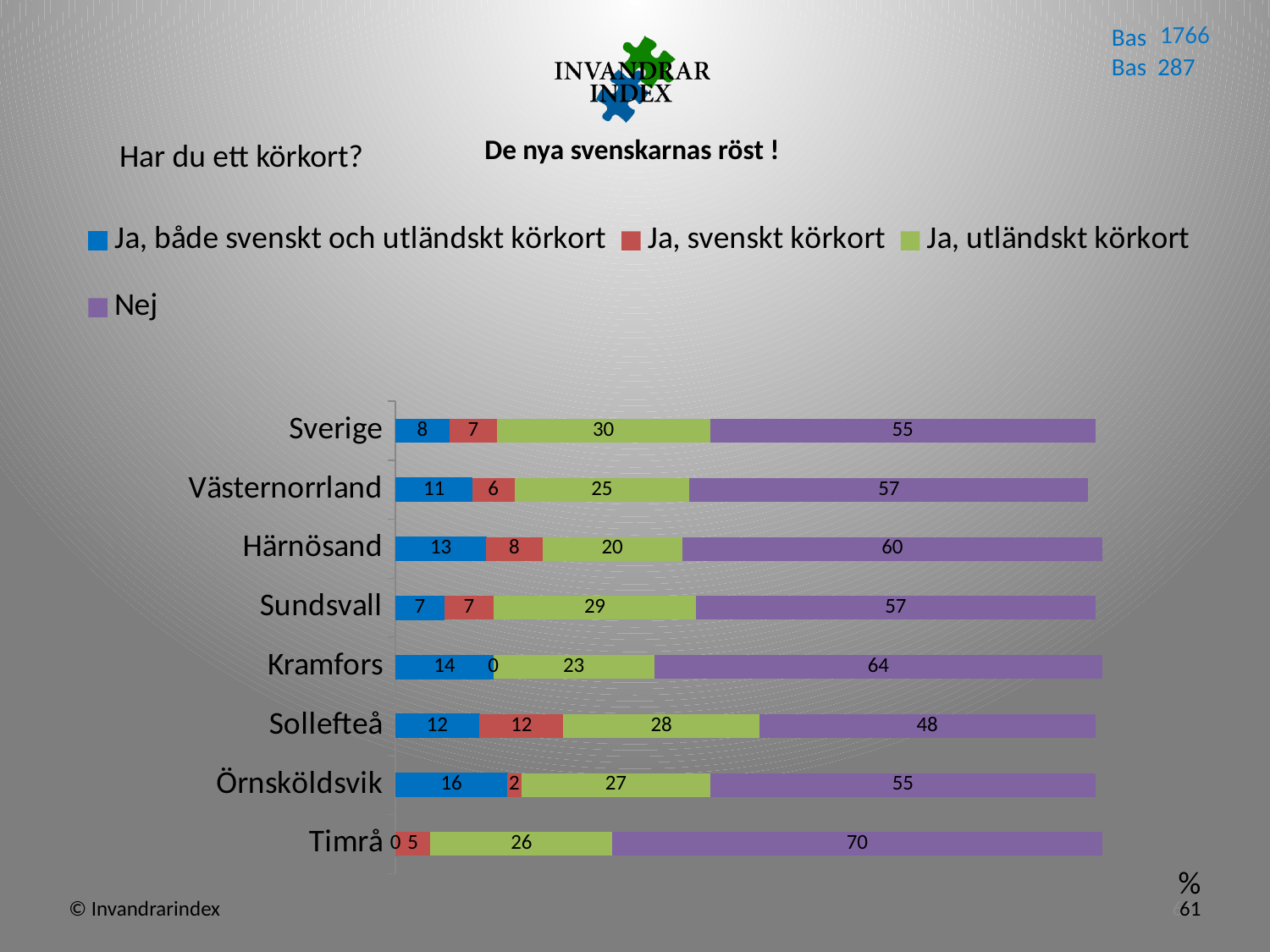
What is the value for "Nej" for Timrå? 70 What is the difference between the "Nej" values for Timrå and Sollefteå? 22 What is the total of the stacked bar for Sollefteå? 100 What is the value for "Ja, både svenskt och utländskt körkort" for Örnsköldsvik? 16 What is the value for "Ja, utländskt körkort" for Sverige? 30 What is the value for "Ja, svenskt körkort" for Kramfors? 0 What kind of chart is shown on the slide? Stacked bar chart Which category has the lowest value for "Nej"? Sollefteå How many series does the legend list? 4 Which category has the highest value for "Nej"? Timrå Which is larger, the "Ja, utländskt körkort" value for Sundsvall or for Härnösand? Sundsvall How many categories are shown on the chart? 8